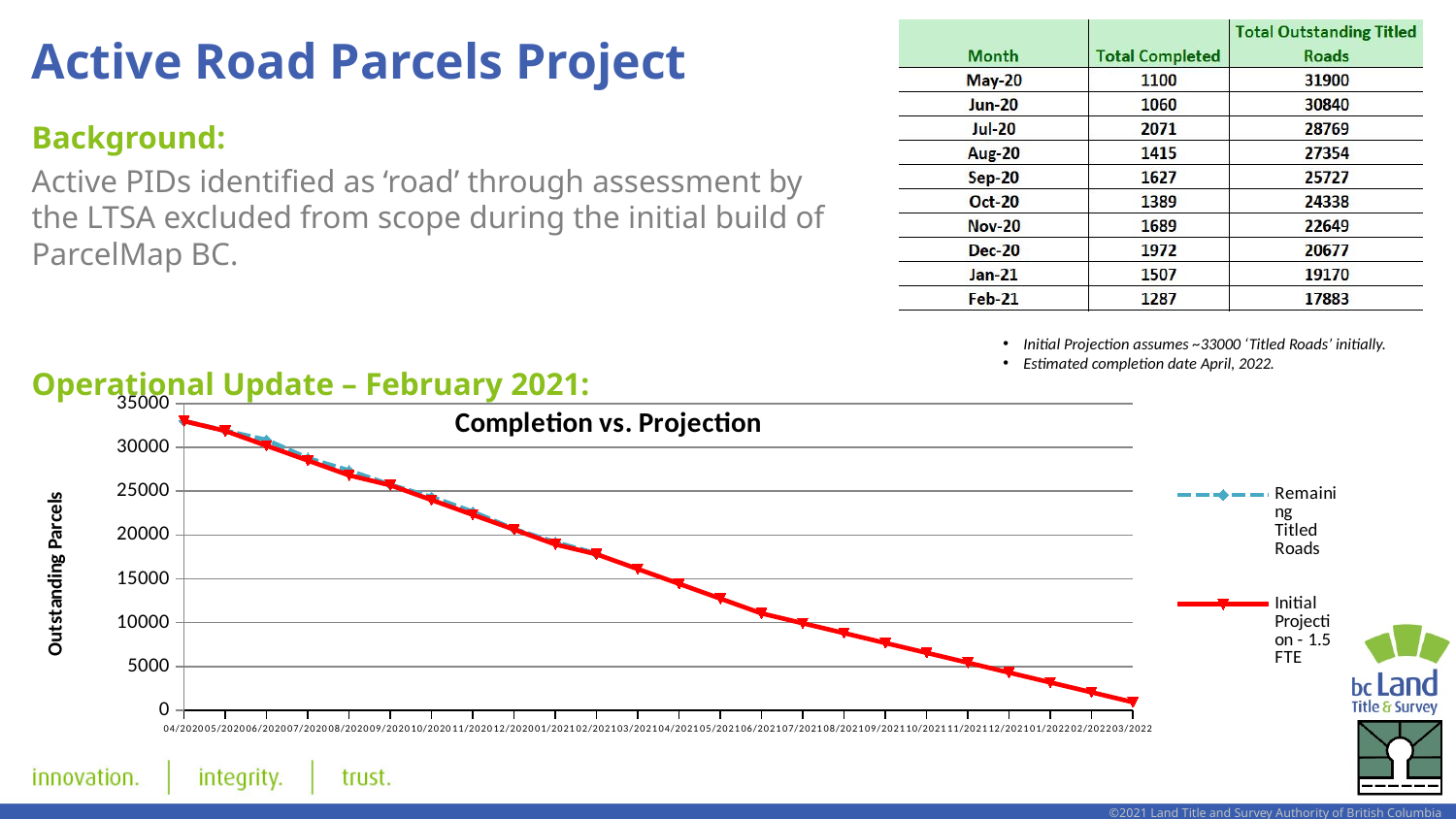
In the 'Completion vs. Projection' chart, is the 'Remaining Titled Roads' value at 06/2020 greater or less than 30000? greater How many series does the legend of the 'Completion vs. Projection' chart list? 2 What type of chart is 'Completion vs. Projection'? line chart What is the y-axis label of the 'Completion vs. Projection' chart? Outstanding Parcels In the 'Completion vs. Projection' chart, is the 'Initial Projection - 1.5 FTE' value at 04/2020 greater or less than 30000? greater How many points are labelled along the x axis of the 'Completion vs. Projection' chart? 24 In the 'Completion vs. Projection' chart, is the 'Initial Projection - 1.5 FTE' value at 08/2021 greater or less than 10000? less In the 'Completion vs. Projection' chart, do the values of the 'Initial Projection - 1.5 FTE' series rise or fall along the x axis? fall What is the title of the line chart on the slide? Completion vs. Projection